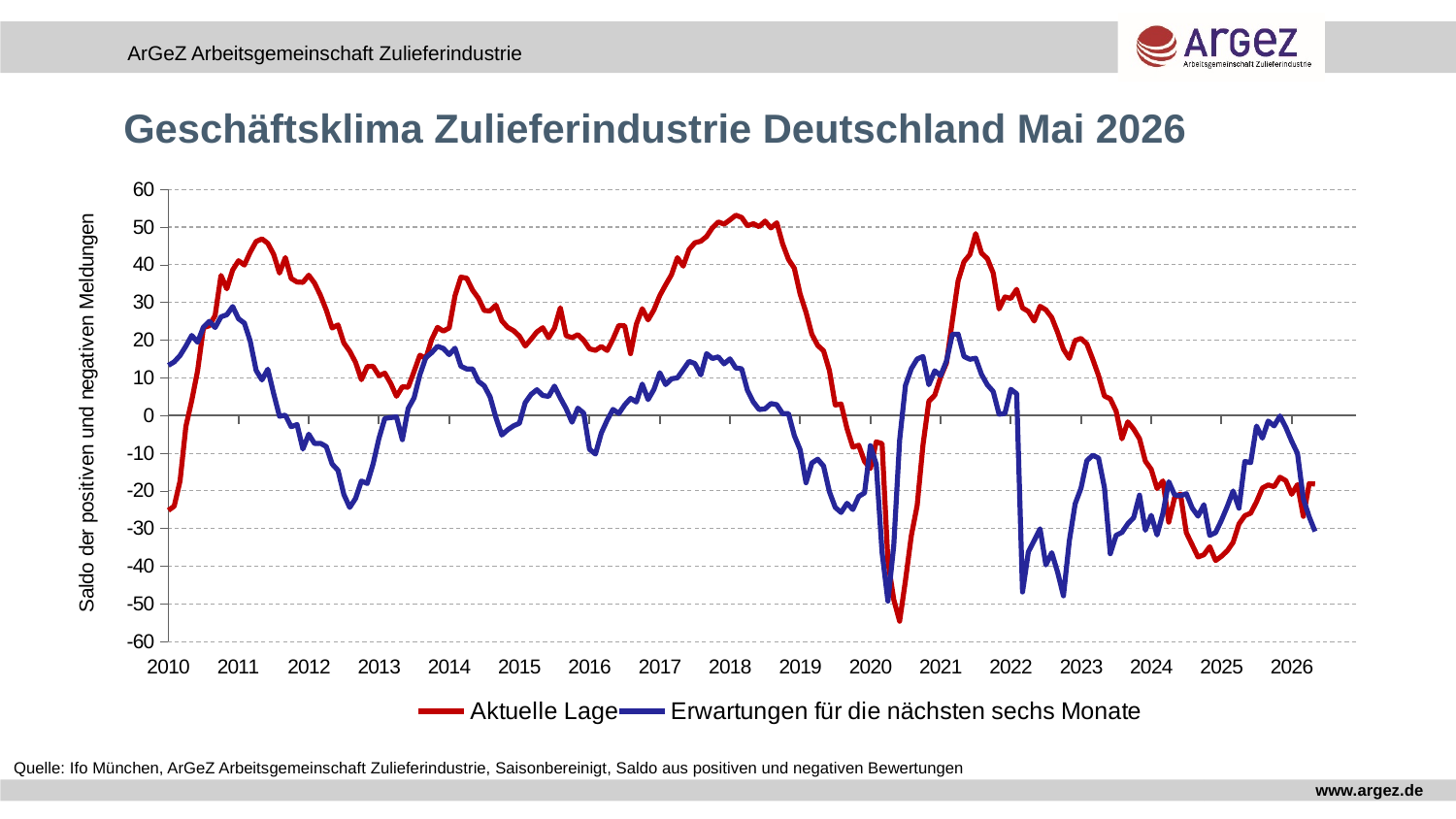
Which colour is used for the 'Aktuelle Lage' series? red How many series does the legend list? 2 How many year labels are shown on the x axis? 17 What kind of chart is shown on the slide? line chart Is the lowest value of 'Erwartungen für die nächsten sechs Monate' in 2020 greater or less than -40? less Is the lowest value of 'Aktuelle Lage' in 2020 greater or less than -50? less What is the highest value shown on the y axis? 60 What is the title of the chart? Geschäftsklima Zulieferindustrie Deutschland Mai 2026 Does 'Aktuelle Lage' rise or fall between the start of 2010 and the start of 2011? rise At the start of 2018, which series has the higher value, 'Aktuelle Lage' or 'Erwartungen für die nächsten sechs Monate'? Aktuelle Lage Is the peak value of 'Aktuelle Lage' around 2018 greater or less than 40? greater Does 'Aktuelle Lage' rise or fall between 2018 and 2020? fall